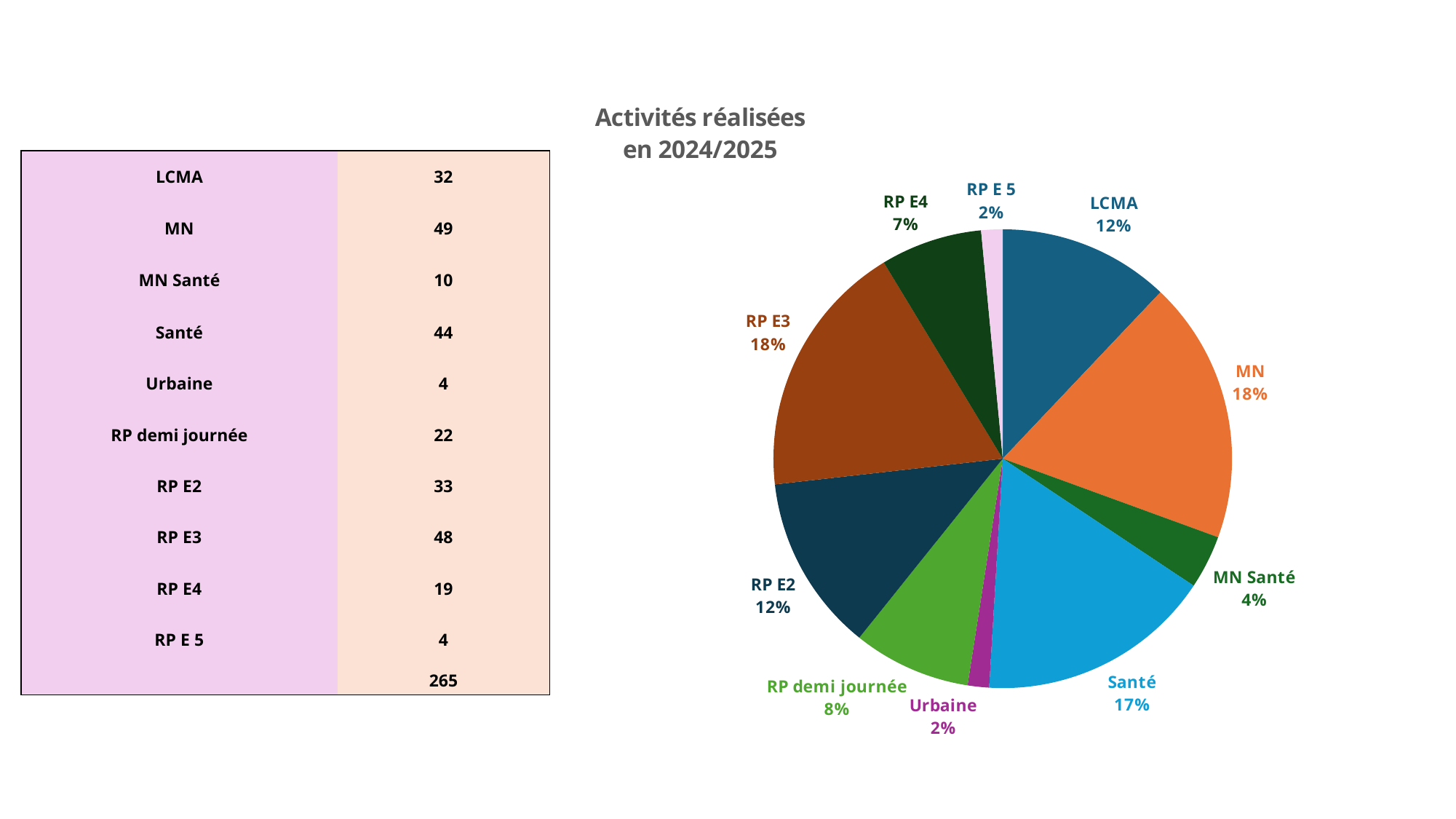
What colour is the Urbaine slice in the pie chart? purple Which slice is larger in the pie chart, Santé or MN Santé? Santé What share of the pie does Santé represent? 17% How many slices does the pie chart have? 10 What percentage is shown for LCMA in the pie chart? 12% What percentage is shown for RP demi journée in the pie chart? 8% What share of the pie does RP E3 represent? 18% What kind of chart is shown on the slide? pie chart What is the difference in percentage points between the MN slice and the RP E4 slice? 11 What is the title of the pie chart? Activités réalisées en 2024/2025 What percentage is shown for MN Santé in the pie chart? 4% Which slice is larger in the pie chart, RP E4 or RP E2? RP E2